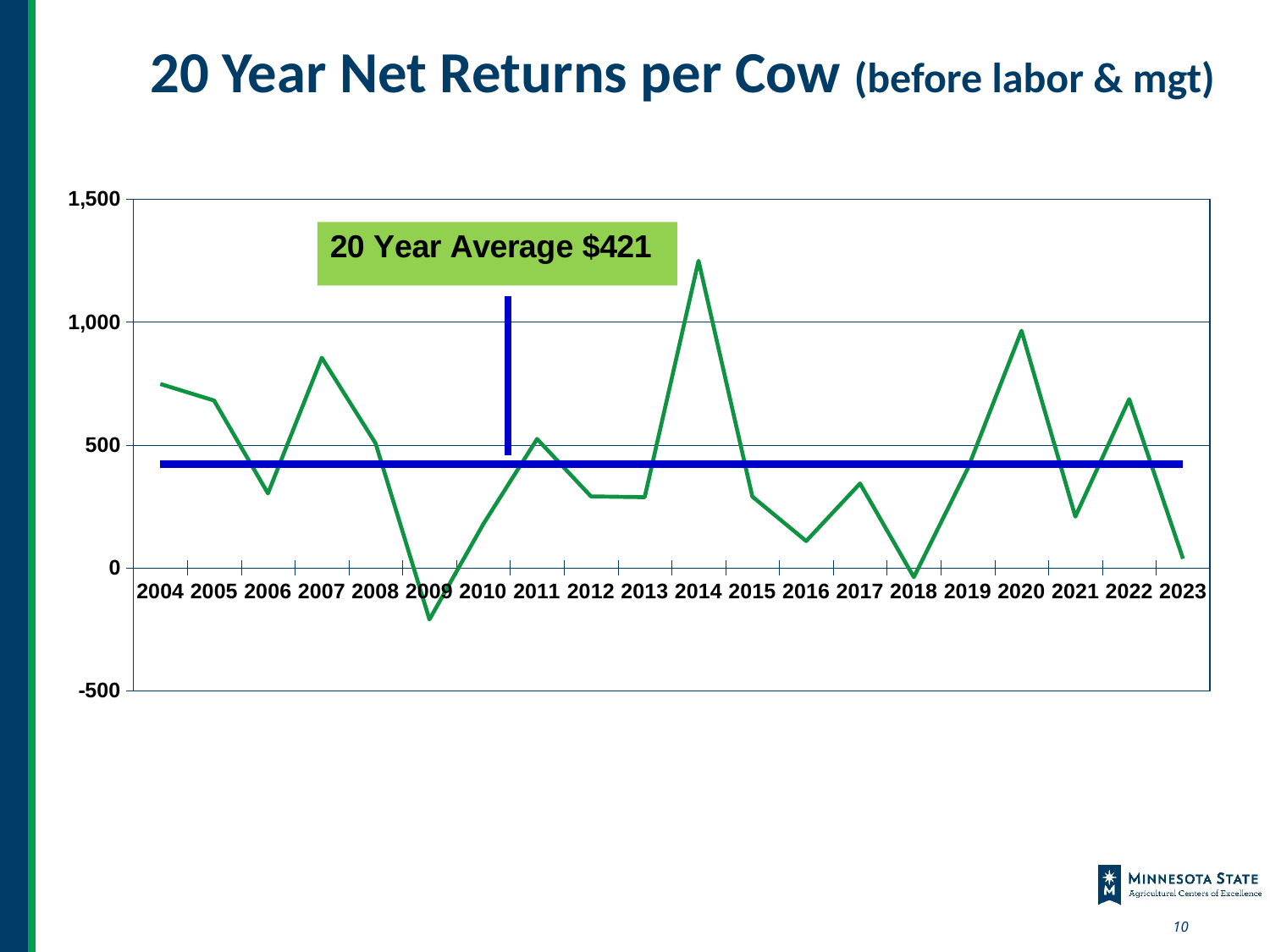
Is the value for 2014 greater or less than 1,000? greater What is the 20 year average net return per cow shown on the chart? $421 Which year has the lowest net return per cow? 2009 Is the value for 2006 greater or less than 500? less Which year has the larger net return per cow, 2016 or 2017? 2017 Is the value for 2009 greater or less than 0? less Which year has the highest net return per cow? 2014 Which year has the larger net return per cow, 2014 or 2020? 2014 How many years are plotted along the x axis of the chart? 20 What kind of chart is shown on the slide? line chart Do the net returns per cow rise or fall from 2022 to 2023? fall